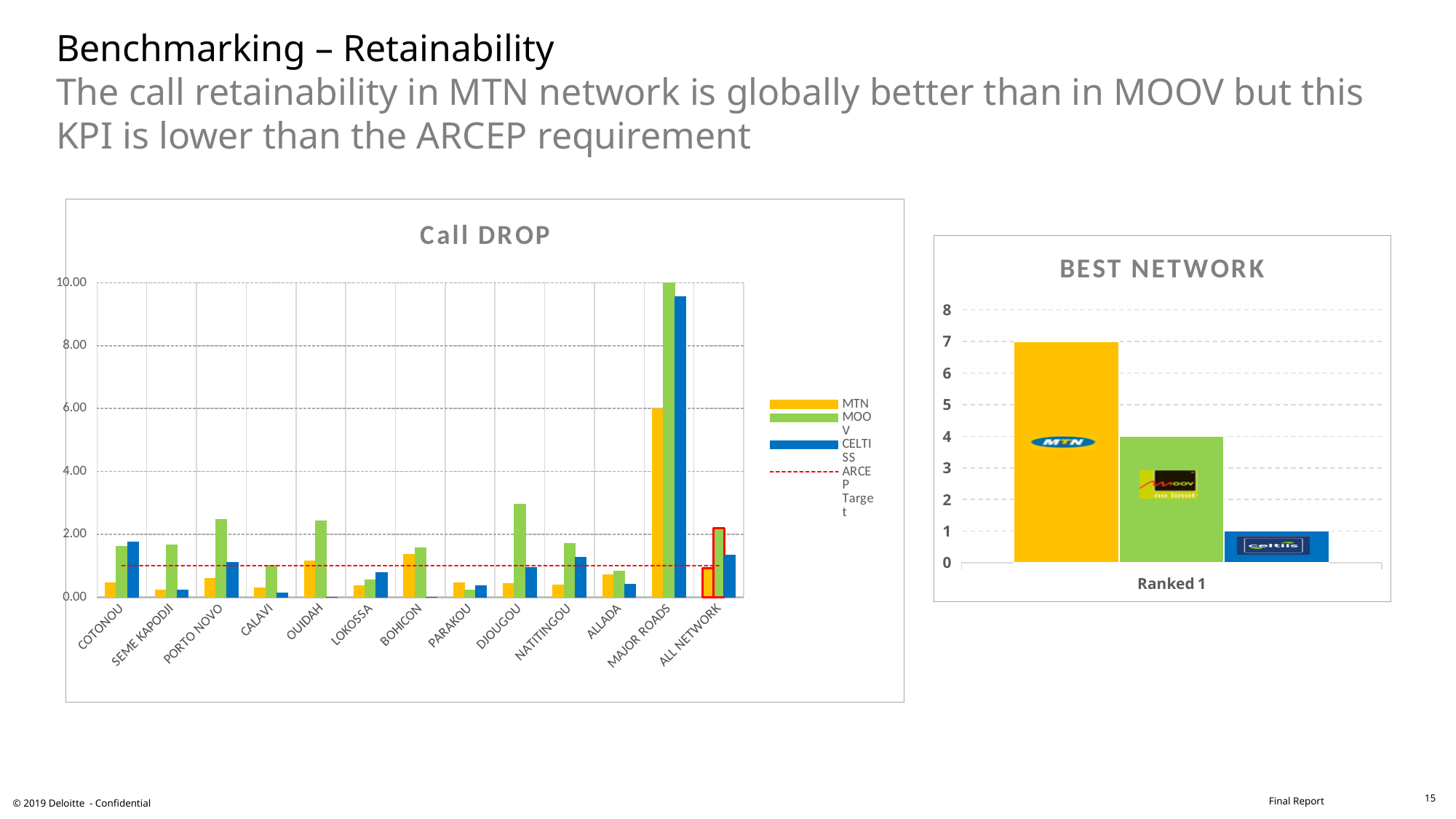
How many categories are shown on the x axis of the "Call DROP" chart? 13 In the "BEST NETWORK" chart, what is the value for MTN? 7 How many entries does the legend of the "Call DROP" chart list? 4 In the "Call DROP" chart, is the MOOV value for MAJOR ROADS greater or less than 8.00? greater In the "BEST NETWORK" chart, what is the difference between the MTN value and the MOOV value? 3 In the "Call DROP" chart, which is larger for COTONOU: the MTN bar or the MOOV bar? MOOV In the "Call DROP" chart, how is the ARCEP Target shown? as a red dashed line In the "Call DROP" chart, which category has the highest bar? MAJOR ROADS What kind of chart is the "Call DROP" chart? bar chart In the "BEST NETWORK" chart, what is the value for CELTISS? 1 In the "Call DROP" chart, which is larger for DJOUGOU: the MOOV bar or the CELTISS bar? MOOV In the "Call DROP" chart, is the MTN value for MAJOR ROADS greater or less than 4.00? greater